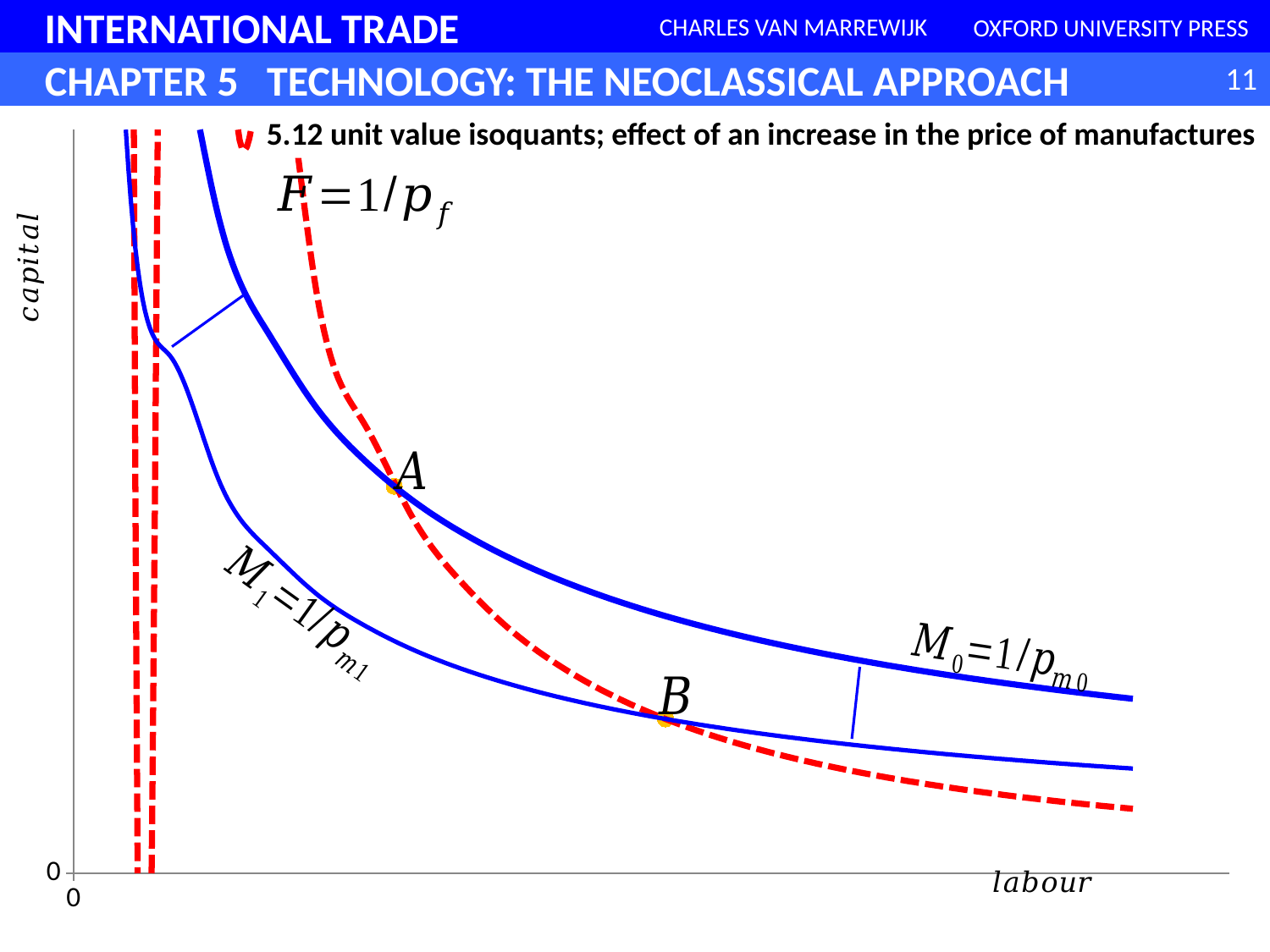
Which labelled point has the higher labour value, A or B? B How many labelled points (marked with letters) are shown on the chart? 2 Which curve is drawn as a red dashed line? F = 1/p_f How many labelled curves are drawn on the chart? 3 On which blue curve does point A lie? M0 = 1/p_m0 What kind of chart is shown on the slide? line chart What is the label of the horizontal axis? labour As labour increases along the x axis, does the M0 = 1/p_m0 curve rise or fall? fall On which blue curve does point B lie? M1 = 1/p_m1 Which labelled point has the higher capital value, A or B? A Which curve passes through both point A and point B? F = 1/p_f Which curve lies higher on the chart, M0 = 1/p_m0 or M1 = 1/p_m1? M0 = 1/p_m0